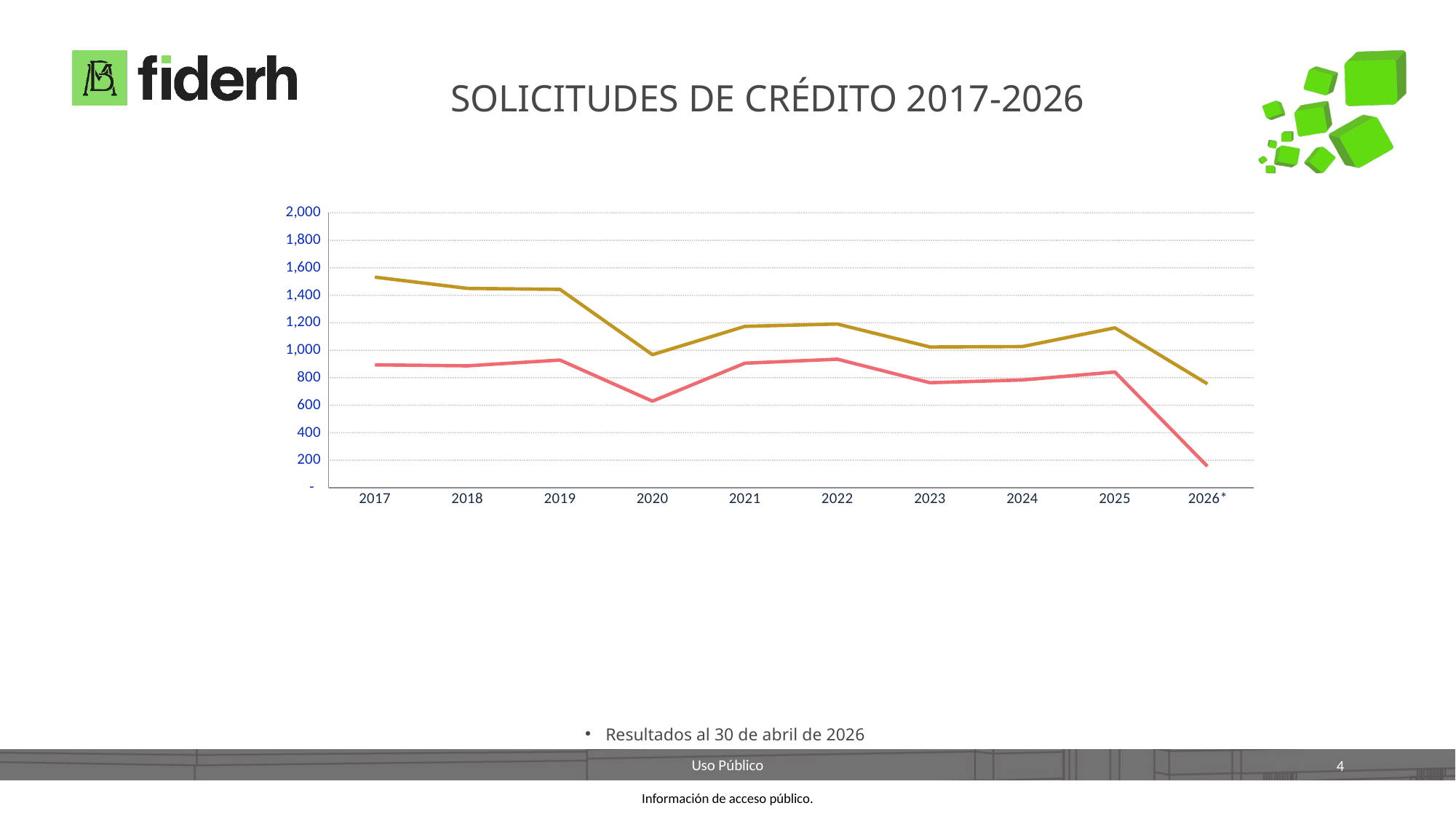
What kind of chart is shown on the slide? line chart What is the title of the chart? SOLICITUDES DE CRÉDITO 2017-2026 How many lines are plotted on the chart? 2 Is the value of the gold line for 2017 greater or less than 1,400? greater Does the gold line overall rise or fall from 2017 to 2026*? fall Is the value of the gold line for 2020 greater or less than 1,000? less In which year does the gold (upper) line reach its lowest value? 2026* In which year does the pink (lower) line reach its lowest value? 2026* How many years are shown along the x axis of the chart? 10 Which is larger for the gold line: the value for 2019 or the value for 2020? 2019 Is the value of the pink line for 2026* greater or less than 200? less In which year does the gold (upper) line reach its highest value? 2017